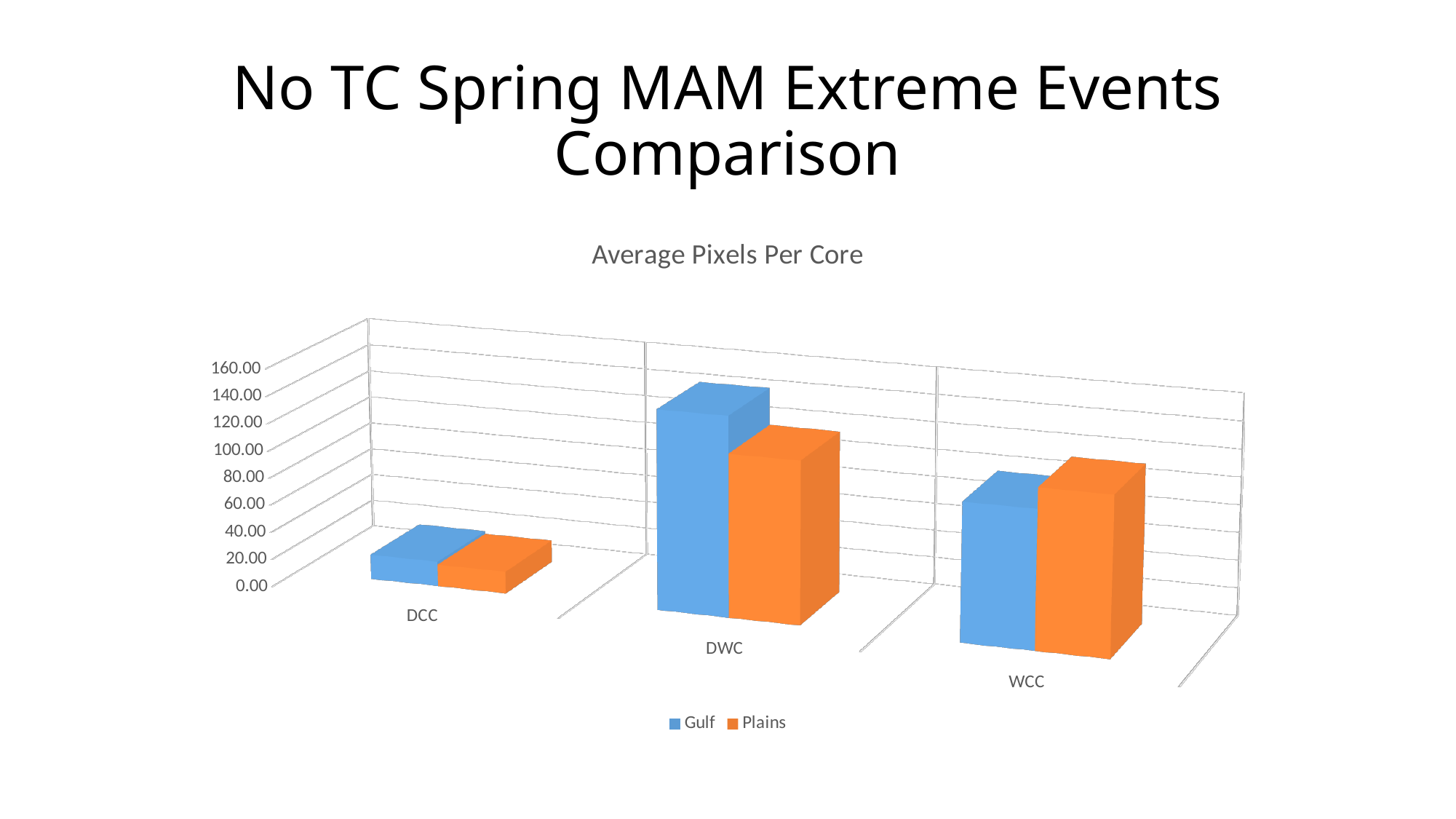
How many categories are shown on the x axis? 3 Is the Plains value for DWC greater or less than 80.00? greater What is the title of the chart? Average Pixels Per Core Which is larger, the Gulf value for DWC or the Gulf value for DCC? DWC Which category has the highest Gulf value? DWC Is the Gulf value for DCC greater or less than 40.00? less Is the Gulf value for WCC greater or less than 40.00? greater How many series does the legend list? 2 Which series is shown in orange in the legend? Plains Which category has the lowest Plains value? DCC What kind of chart is shown on the slide? bar chart